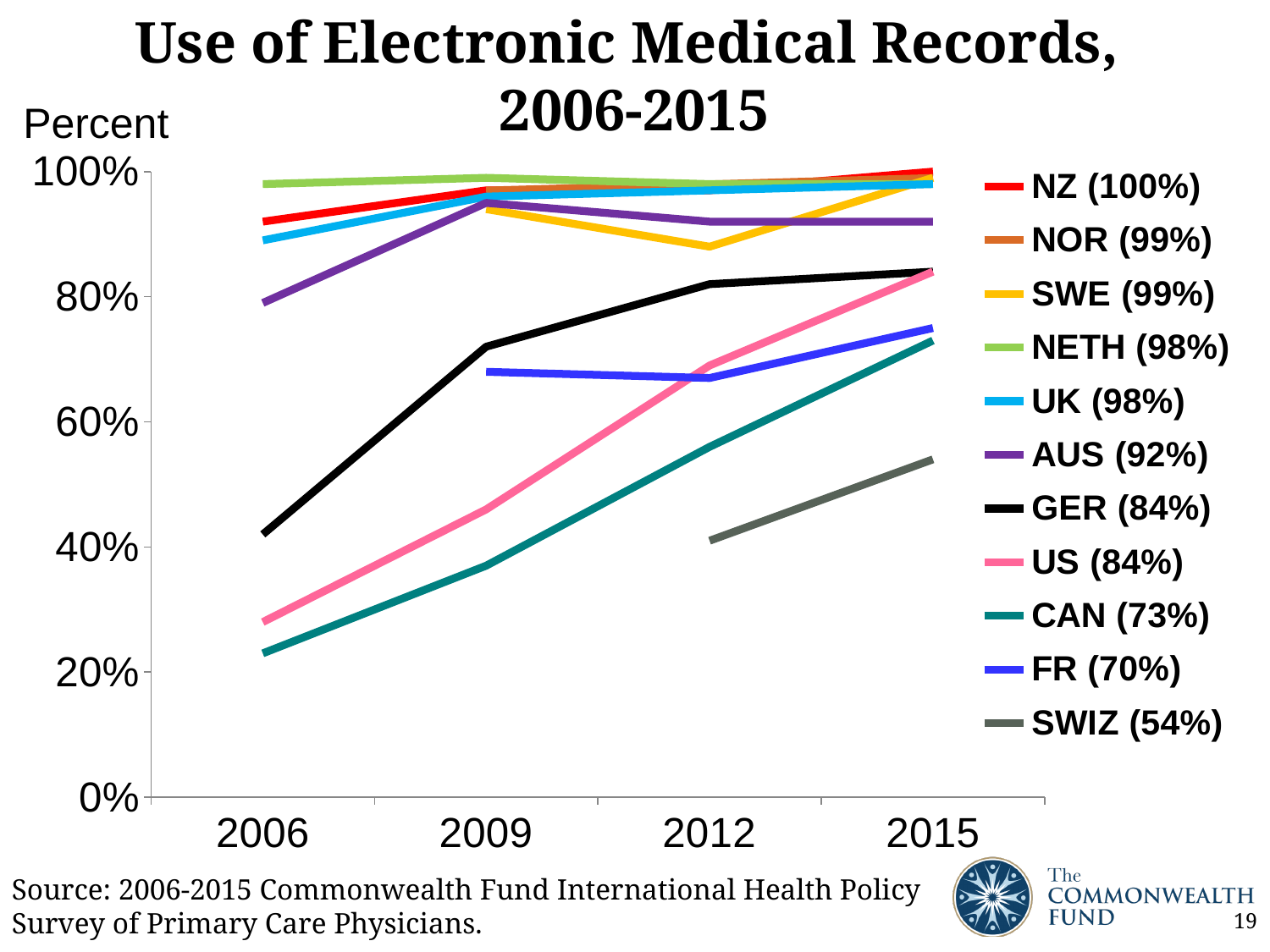
Is the value for CAN in 2006 greater or less than 40%? less Does the US line rise or fall from 2006 to 2015? rises What is the title of the chart? Use of Electronic Medical Records, 2006-2015 How many years are labelled on the x axis? 4 Which country has the highest value in 2015? NZ What kind of chart is shown on the slide? line chart What is the 2015 value for SWIZ shown in the legend? 54% Which country has the lowest value in 2015? SWIZ How many series (countries) does the legend list? 11 What is the 2015 value for NZ shown in the legend? 100% What is the difference between the 2015 values for NZ and SWIZ? 46 percentage points